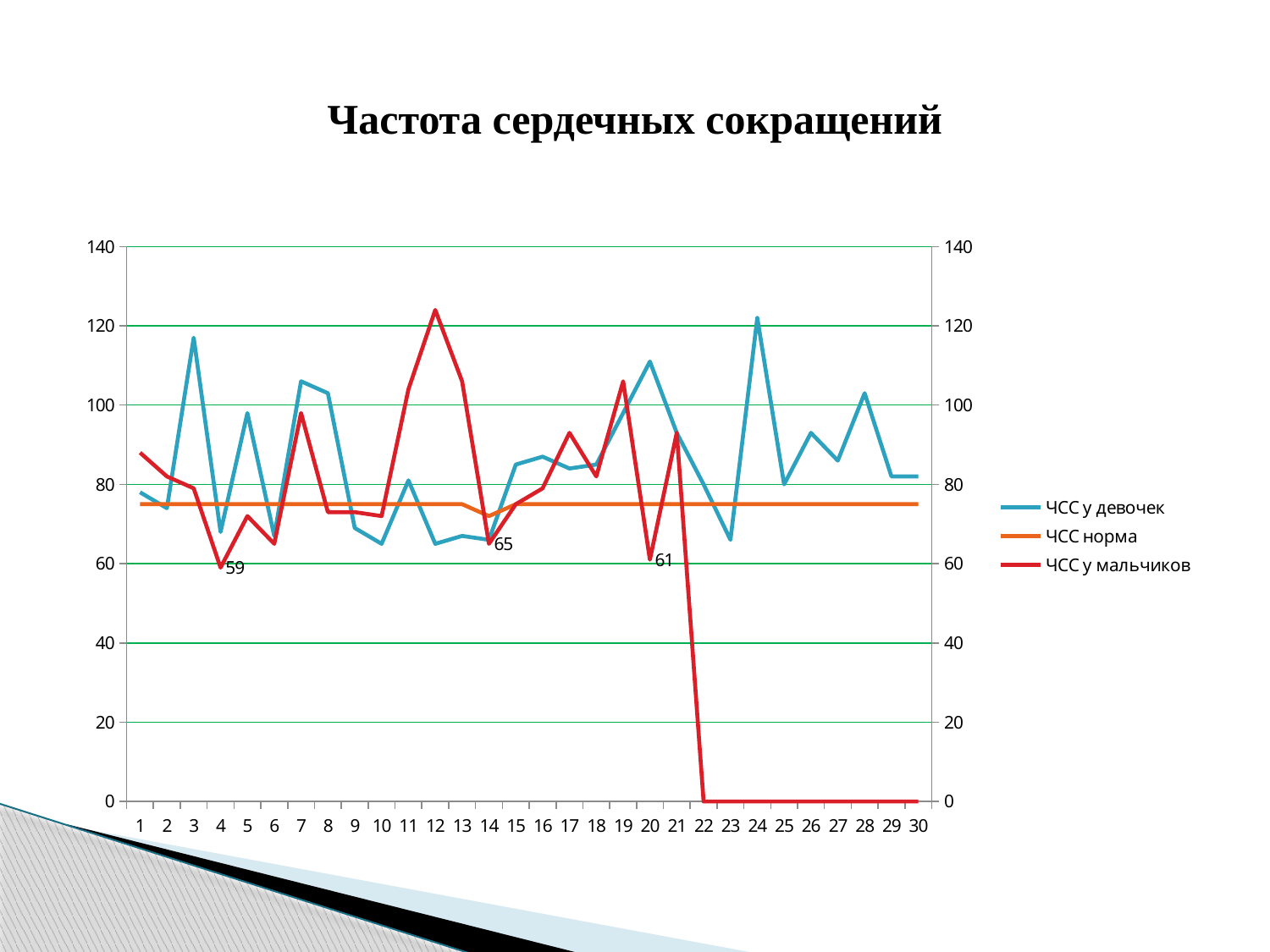
What kind of chart is shown on the slide? line chart What is the difference between the ЧСС у мальчиков values at point 14 and point 4? 6 Is the value for ЧСС у мальчиков at point 12 greater or less than 120? greater Is the value for ЧСС норма greater or less than 80? less At point 12, which series has the larger value, ЧСС у девочек or ЧСС у мальчиков? ЧСС у мальчиков What is the value of ЧСС у мальчиков at point 20? 61 What is the value of ЧСС у мальчиков at point 14? 65 What is the value of ЧСС у мальчиков at point 4? 59 Is the value for ЧСС у девочек at point 3 greater or less than 100? greater What is the title of the chart? Частота сердечных сокращений How many series does the legend list? 3 How many points are there along the x axis? 30